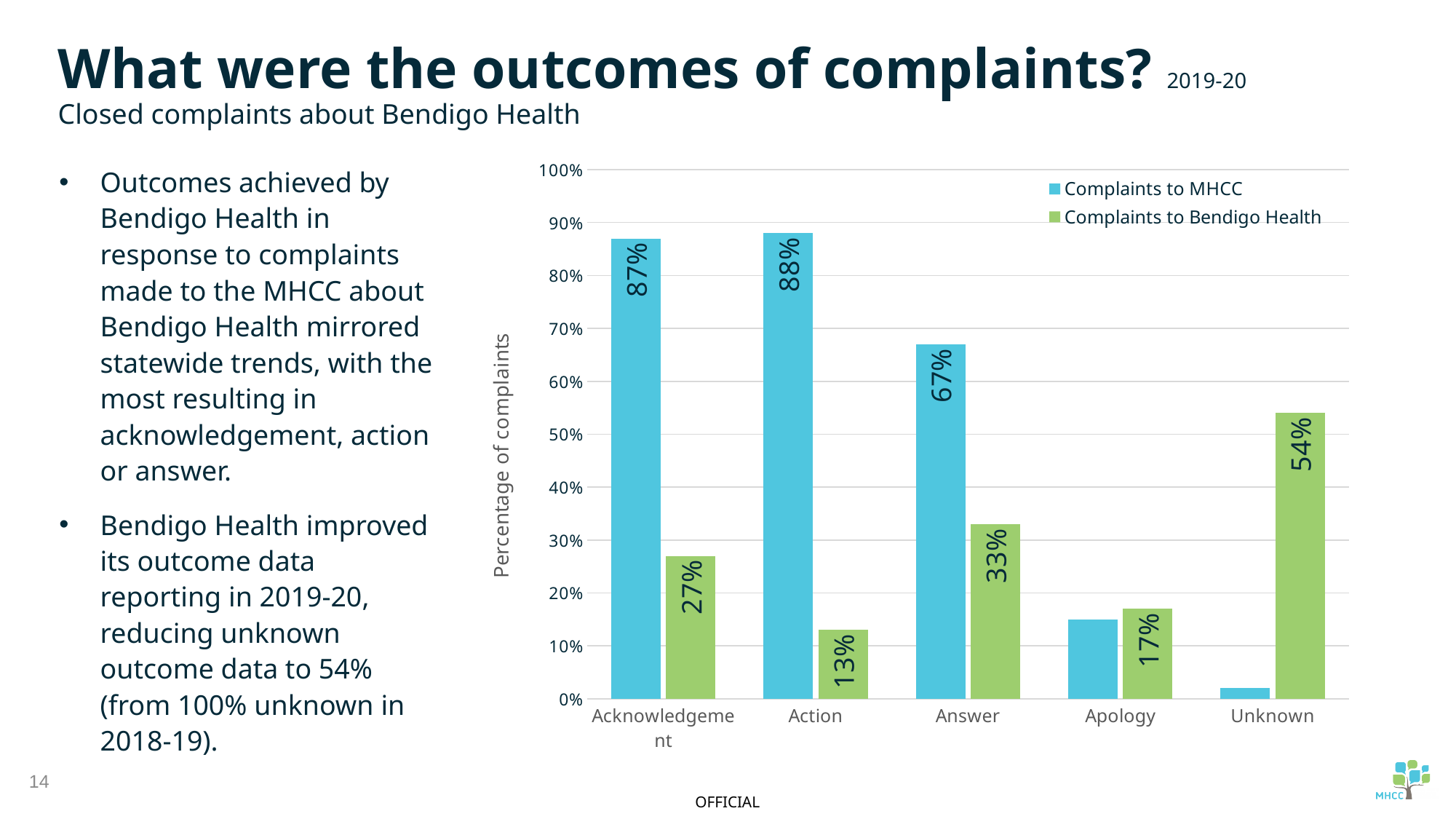
Which outcome category has the lowest value for Complaints to Bendigo Health? Action What percentage of complaints to Bendigo Health had an unknown outcome? 54% What is the difference between the Complaints to MHCC and Complaints to Bendigo Health values for Acknowledgement? 60 percentage points Which outcome category has the highest value for Complaints to Bendigo Health? Unknown What percentage of complaints to MHCC resulted in acknowledgement? 87% What is the value for Answer in the Complaints to Bendigo Health series? 33% Is the Complaints to MHCC value for Unknown greater or less than 10%? less How many outcome categories are shown on the x axis of the chart? 5 What type of chart is shown on the slide? Bar chart For Apology, which series has the larger value: Complaints to MHCC or Complaints to Bendigo Health? Complaints to Bendigo Health How many series does the chart's legend list? 2 Is the Complaints to MHCC value for Apology greater or less than 20%? less